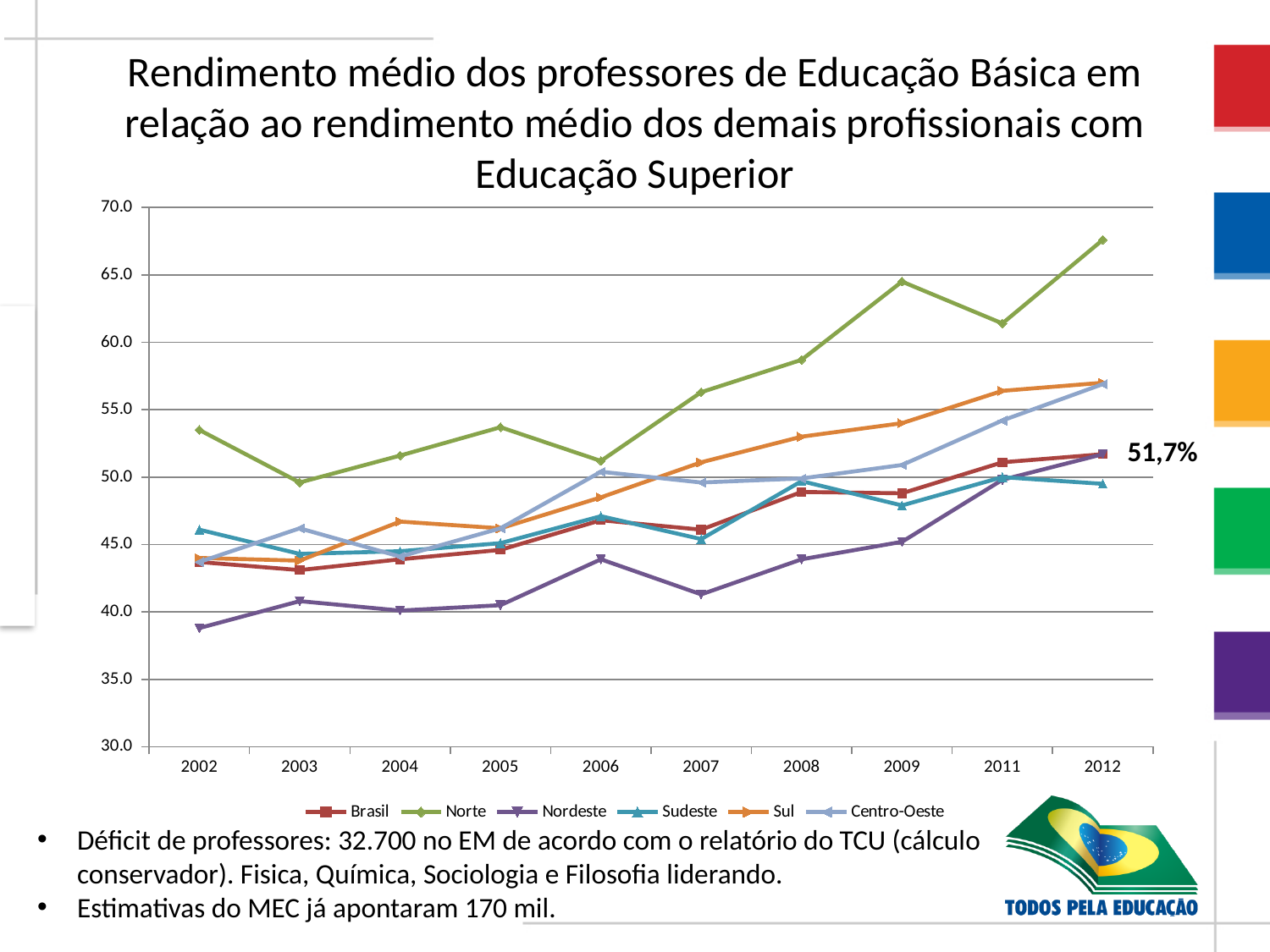
Which series has the lowest value in 2002? Nordeste How many years are plotted along the x axis? 10 Does the Norte series rise or fall between 2009 and 2011? fall Is the value for Norte in 2012 greater or less than 65.0? greater Which series is listed first in the legend? Brasil In which year does the Norte series reach its highest value? 2012 What kind of chart is shown on the slide? line chart Which is larger in 2012, the value for Sul or the value for Sudeste? Sul How many series does the legend list? 6 What value is labelled for Brasil in 2012? 51,7% Which series has the highest value in 2012? Norte Is the value for Nordeste in 2002 greater or less than 40.0? less